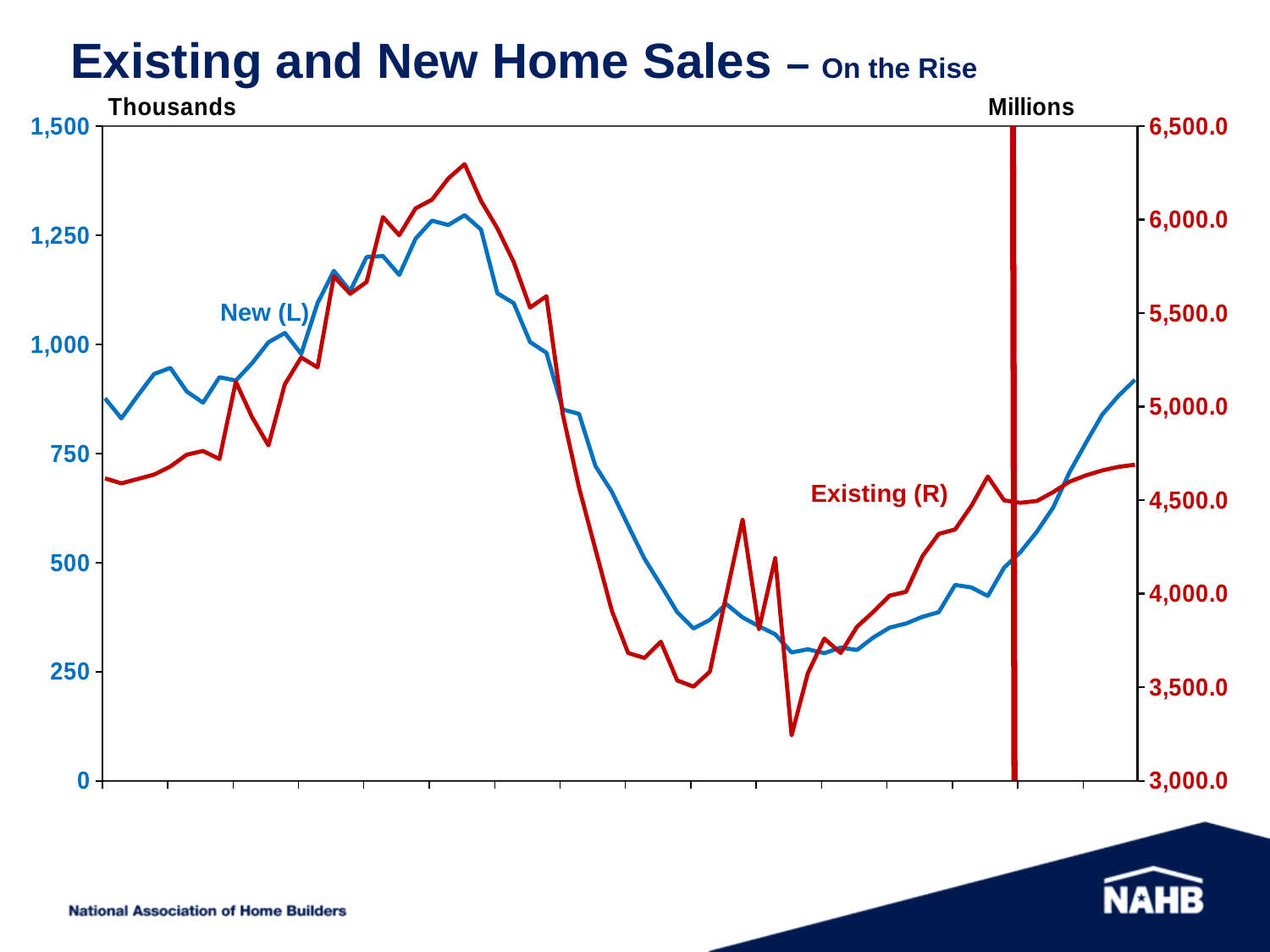
What kind of chart is shown on the slide? Line chart How many data series are plotted on the chart? 2 What is the title of the chart on the slide? Existing and New Home Sales – On the Rise What unit label is shown above the left axis, which the New (L) series is plotted against? Thousands Is the lowest value reached by the New (L) series greater or less than 500? less Is the value of the New (L) series at the right end of the chart greater or less than 750? greater Is the highest value reached by the Existing (R) series greater or less than 6,000.0? greater Toward the right end of the chart, are the New (L) and Existing (R) series rising or falling? Rising